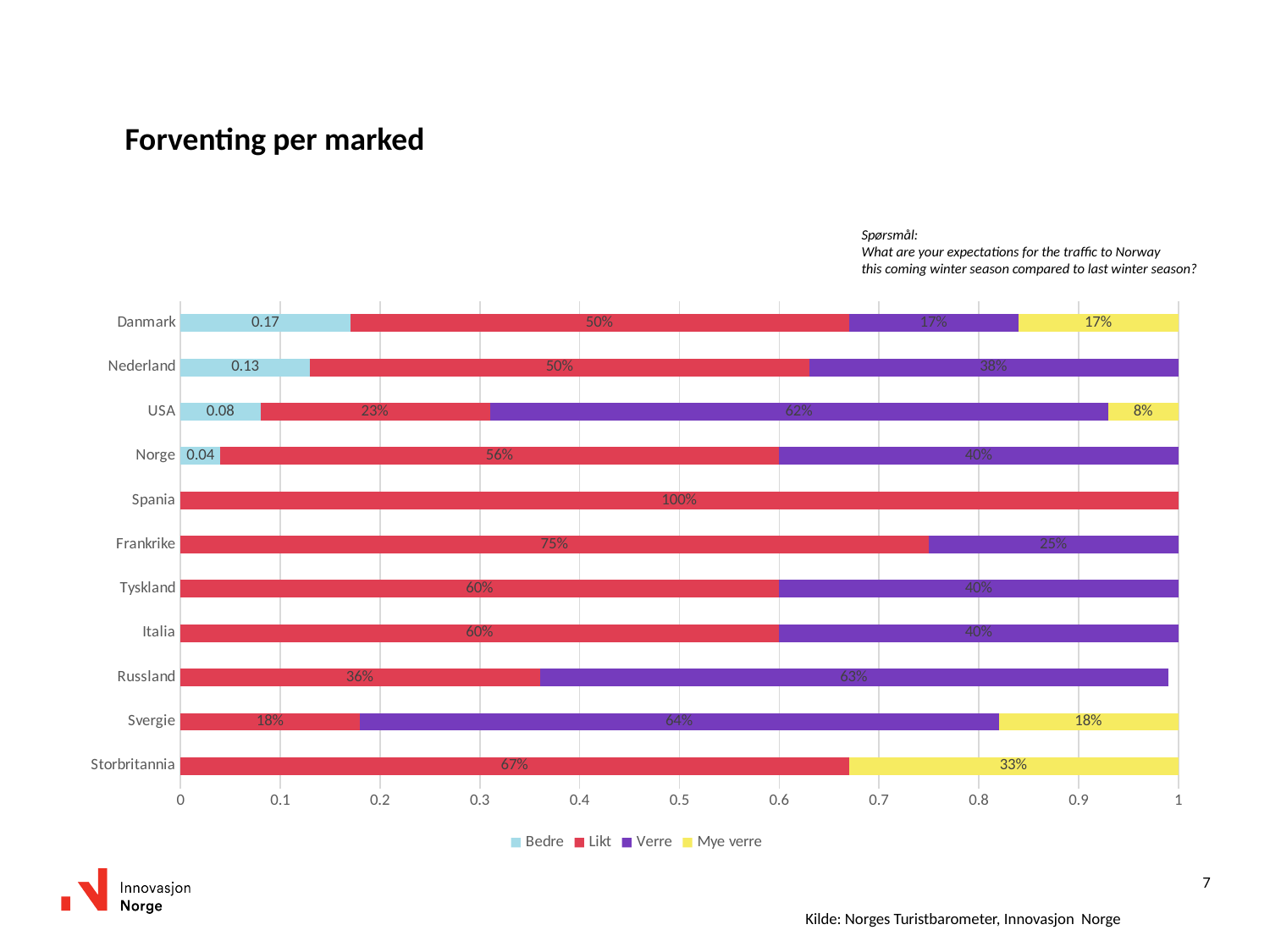
What is the 'Likt' value for Spania? 100% What is the 'Bedre' value for Danmark? 0.17 What is the difference between the 'Likt' value for Frankrike and the 'Likt' value for Tyskland? 15% Which market has the lowest 'Likt' value? Svergie Which market has the highest 'Likt' value? Spania What is the 'Mye verre' value for Storbritannia? 33% What kind of chart is shown on the slide? Stacked bar chart What is the title of the chart? Forventing per marked How many markets (categories) are shown on the chart? 11 What is the 'Verre' value for USA? 62% How many series does the legend list? 4 Which is larger, the 'Verre' value for Russland or the 'Verre' value for Frankrike? Russland